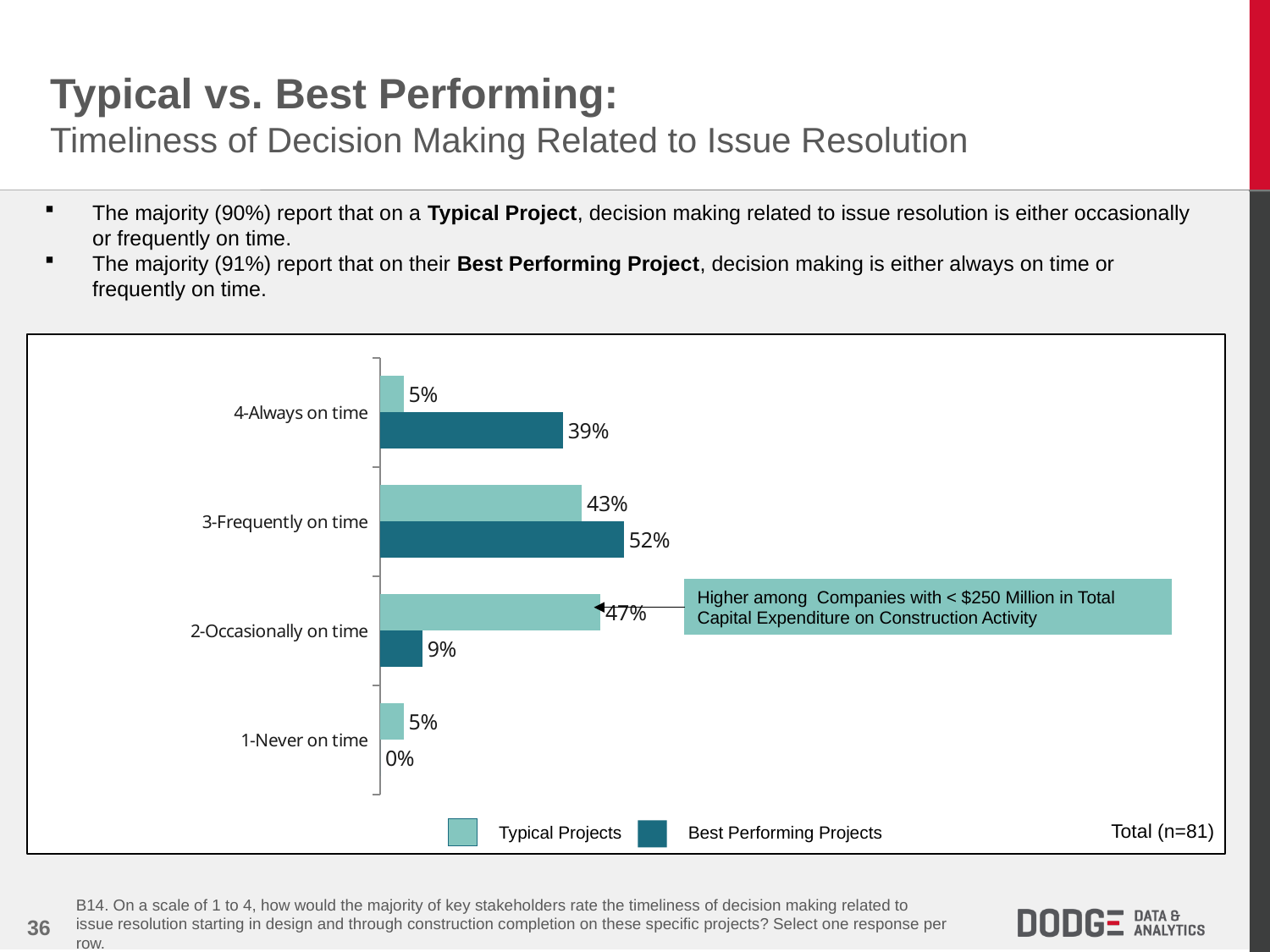
What percentage of Best Performing Projects are rated 1-Never on time? 0% How many categories are shown on the chart? 4 For 3-Frequently on time, which series has the larger value, Typical Projects or Best Performing Projects? Best Performing Projects Which category has the lowest value for Best Performing Projects? 1-Never on time Which category has the highest value for Best Performing Projects? 3-Frequently on time Which category has the highest value for Typical Projects? 2-Occasionally on time What kind of chart is shown on the slide? Bar chart How many series does the legend list? 2 What percentage of Typical Projects are rated 2-Occasionally on time? 47% What percentage of Best Performing Projects are rated 4-Always on time? 39% What is the difference between Typical Projects and Best Performing Projects for 2-Occasionally on time? 38% What is the difference between Best Performing Projects and Typical Projects for 4-Always on time? 34%